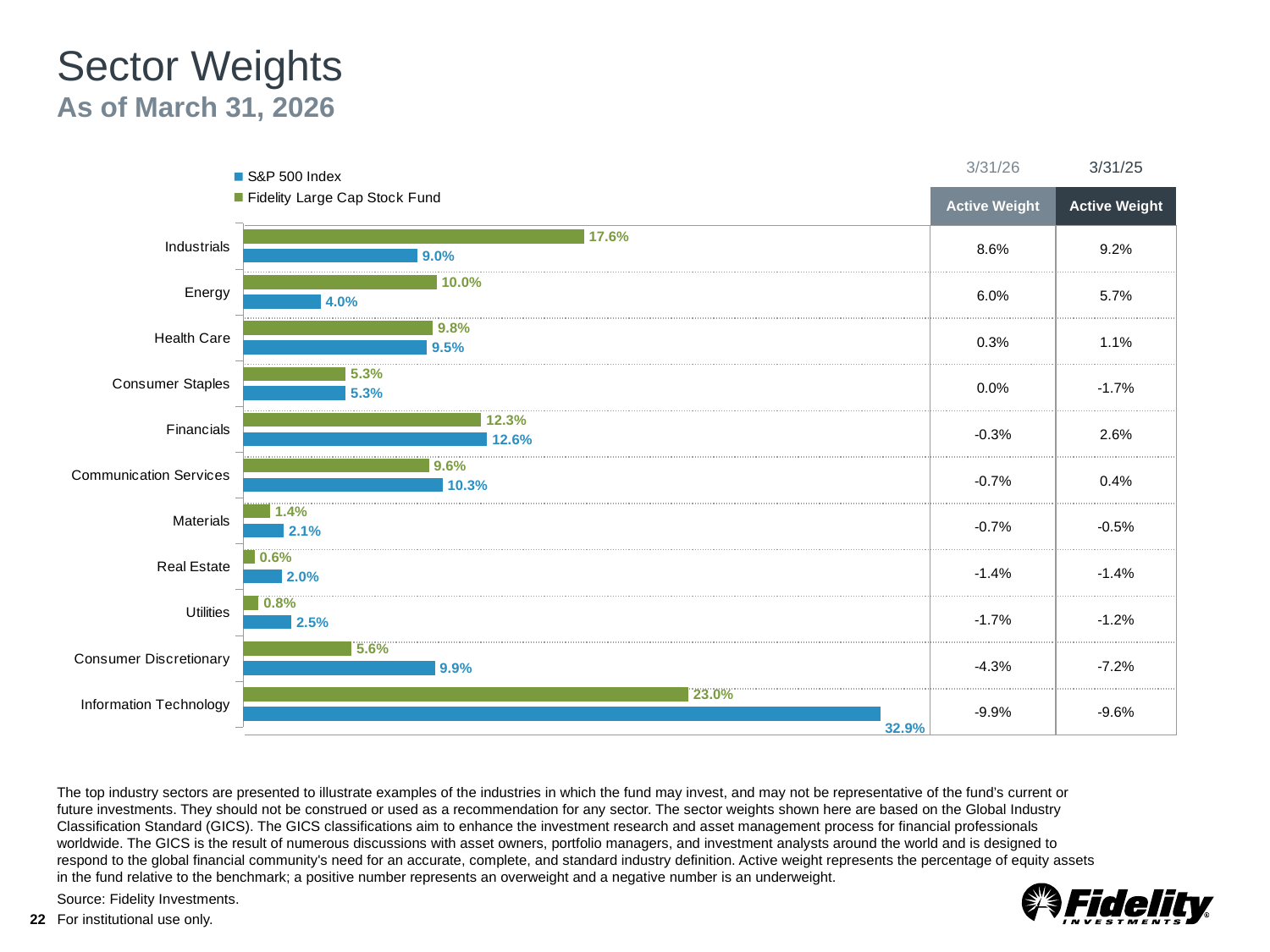
What kind of chart is shown on the slide? Bar chart What is the S&P 500 Index weight for Information Technology? 32.9% What is the Fidelity Large Cap Stock Fund weight for Industrials? 17.6% For Consumer Discretionary, which is larger: the S&P 500 Index weight or the Fidelity Large Cap Stock Fund weight? S&P 500 Index How many series does the chart legend list? 2 What is the S&P 500 Index weight for Energy? 4.0% Which series is shown in green in the chart? Fidelity Large Cap Stock Fund Which sector has the lowest Fidelity Large Cap Stock Fund weight? Real Estate What is the difference between the S&P 500 Index weight and the Fidelity Large Cap Stock Fund weight for Information Technology? 9.9% What is the difference between the Fidelity Large Cap Stock Fund weight and the S&P 500 Index weight for Energy? 6.0% Which sector has the highest Fidelity Large Cap Stock Fund weight? Information Technology How many sectors are shown in the chart? 11